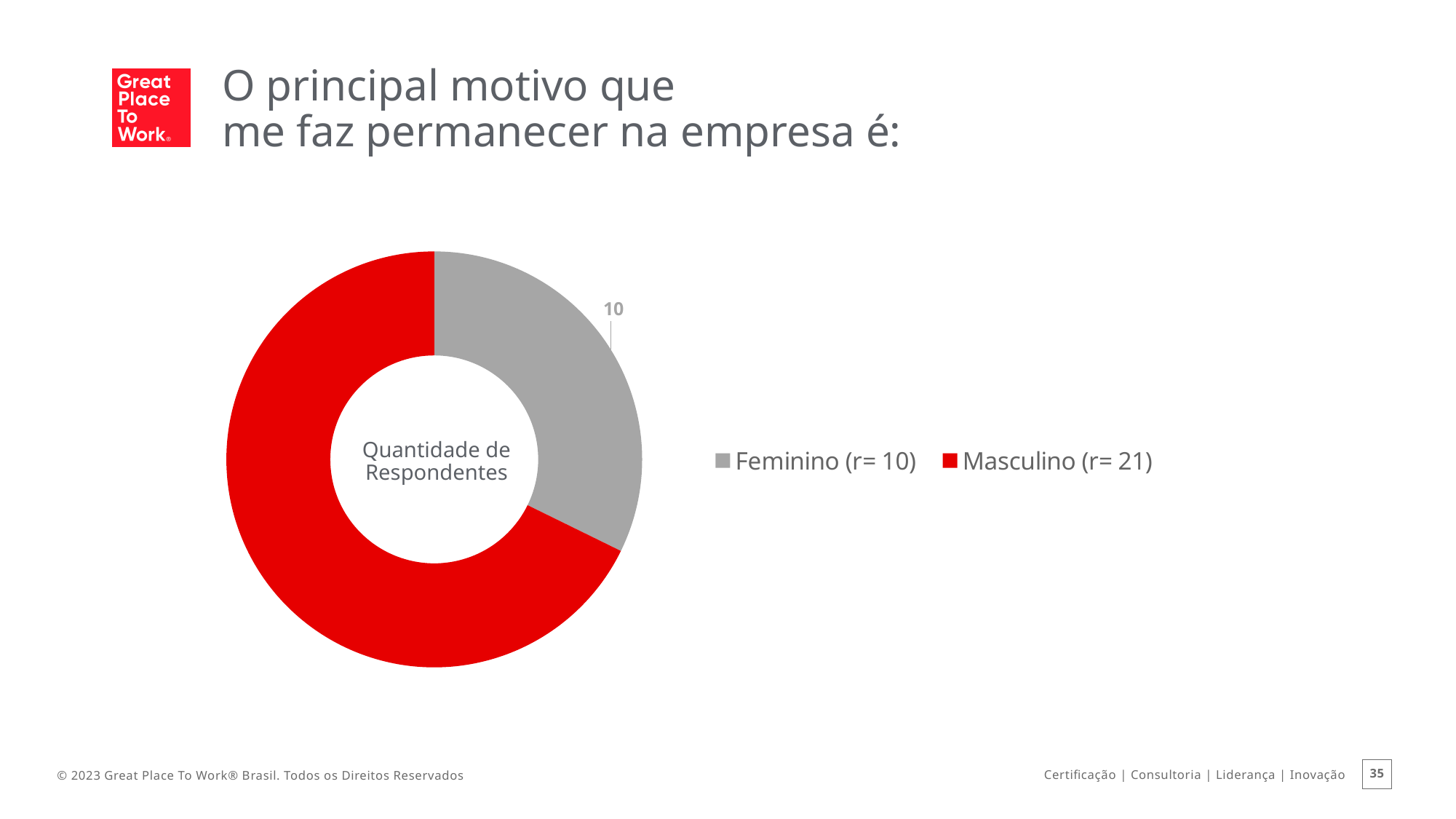
What is the difference between the Masculino and Feminino respondent counts? 11 Which category has the smallest slice? Feminino How many categories does the doughnut chart show? 2 What is the value shown for the Feminino slice? 10 According to the legend, how many respondents are Masculino? 21 How many entries does the legend list? 2 What type of chart is shown on the slide? doughnut chart Which category has the larger slice, Feminino or Masculino? Masculino What text appears in the centre of the doughnut chart? Quantidade de Respondentes Which category has the largest slice? Masculino What is the total number of respondents across both categories? 31 What colour is used for the Masculino slice? red